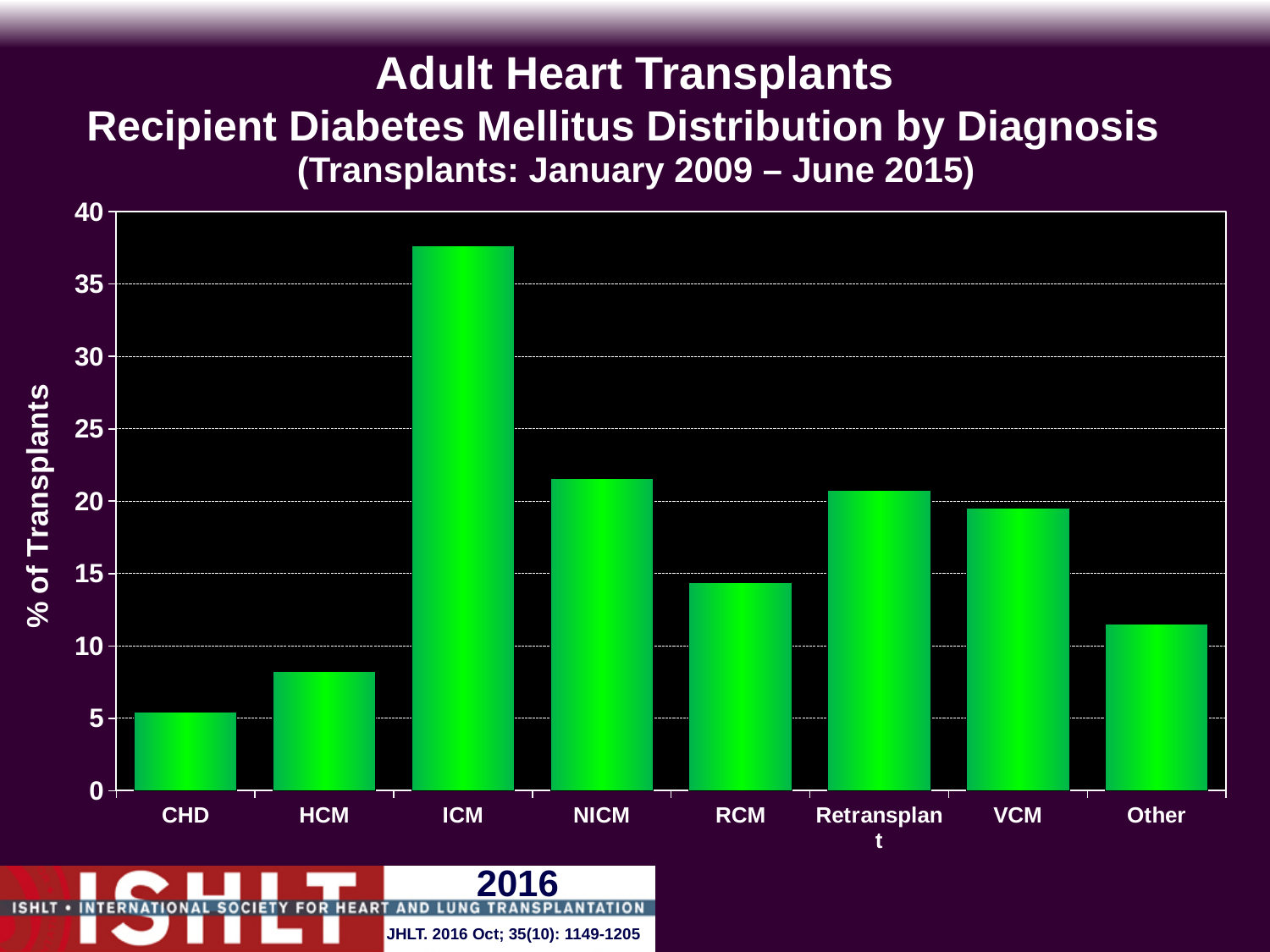
Is the value for HCM greater or less than 10? less Is the value for ICM greater or less than 35? greater Is the value for Other greater or less than 10? greater Which diagnosis has the highest % of transplants? ICM Which is larger, the value for ICM or the value for NICM? ICM What kind of chart is shown on the slide? bar chart What is the label of the y axis? % of Transplants Which is larger, the value for RCM or the value for Other? RCM Which is larger, the value for HCM or the value for CHD? HCM Which diagnosis has the lowest % of transplants? CHD How many diagnosis categories are shown on the x axis? 8